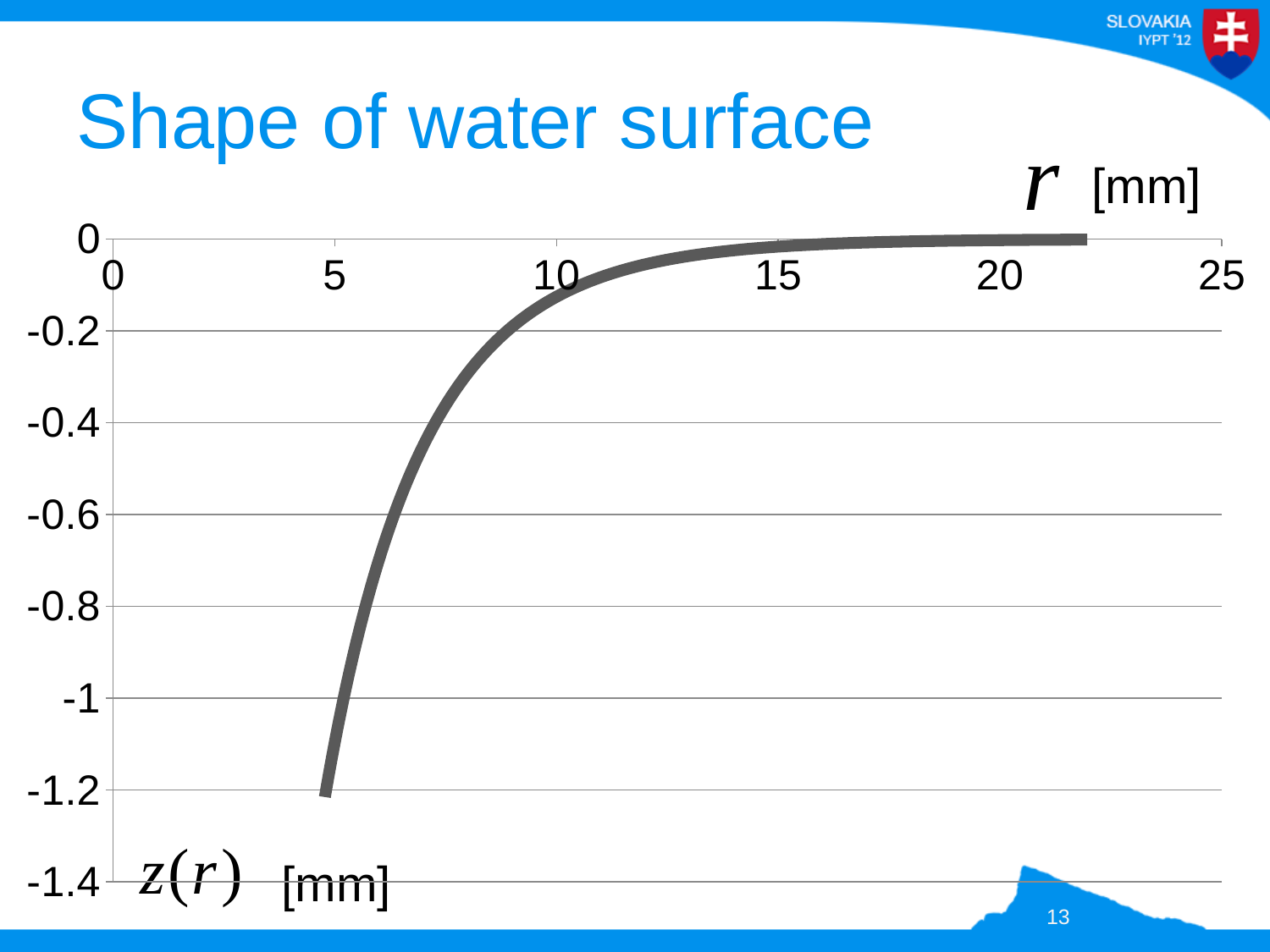
Does z(r) rise or fall as r increases along the x axis? rise Is the value of z(r) at r = 20 mm greater or less than -0.2? greater Is the value of z(r) at r = 15 mm greater or less than -0.2? greater How many lines (series) are plotted on the chart? 1 What kind of chart is shown on the slide? line chart Is the value of z(r) at r = 6 mm greater or less than -0.4? less What is the largest tick value shown on the horizontal axis? 25 What quantity and unit are labelled on the horizontal axis? r [mm] What is the title of the chart? Shape of water surface